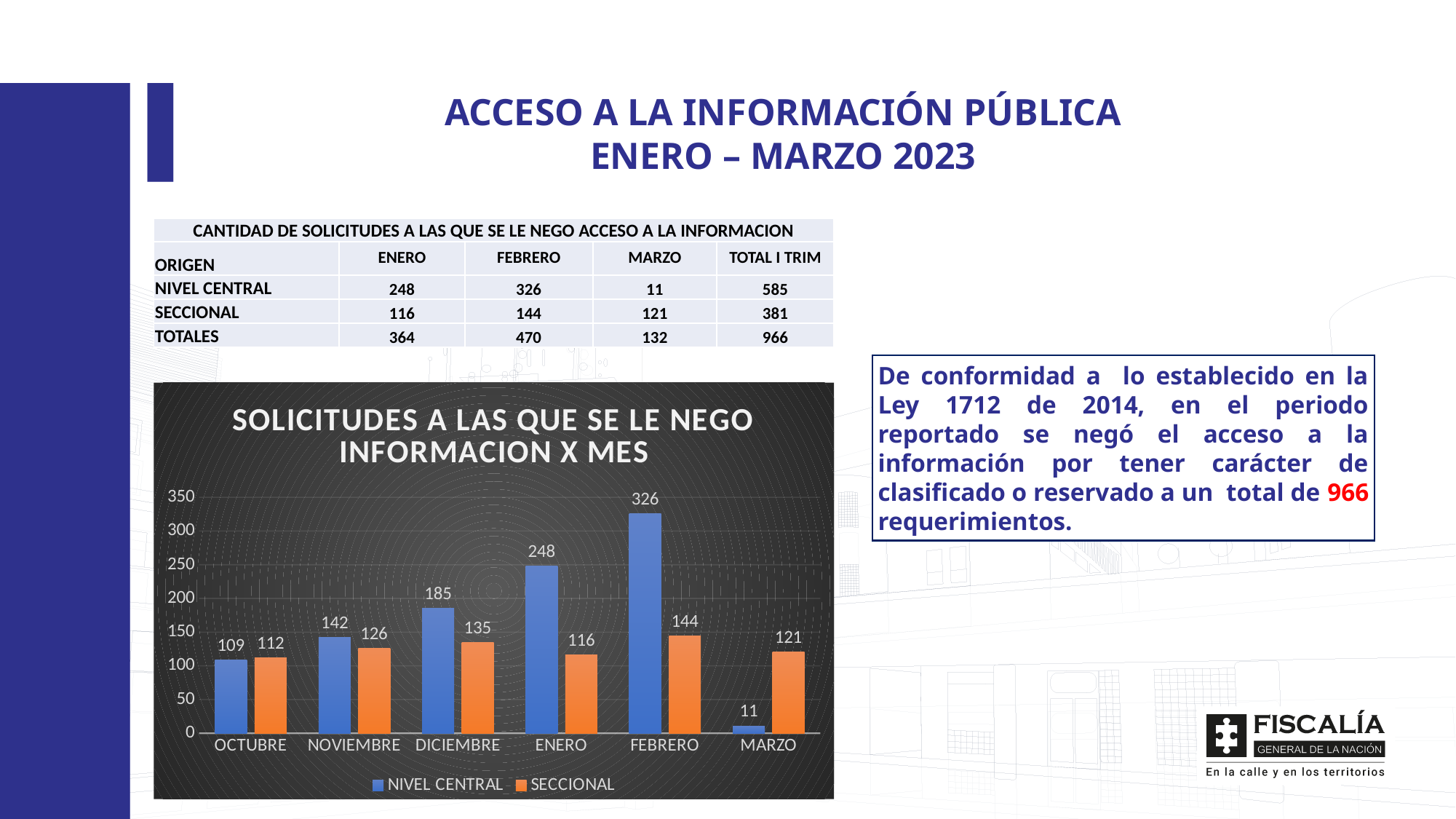
What is the difference between NIVEL CENTRAL and SECCIONAL in ENERO? 132 What is the value for NIVEL CENTRAL in MARZO? 11 How many months are shown on the x axis of the chart? 6 How many series does the chart legend list? 2 In which month is the NIVEL CENTRAL value highest? FEBRERO What is the value for SECCIONAL in DICIEMBRE? 135 In which month is the NIVEL CENTRAL value lowest? MARZO Which is larger in NOVIEMBRE, NIVEL CENTRAL or SECCIONAL? NIVEL CENTRAL What is the value for NIVEL CENTRAL in FEBRERO? 326 What kind of chart is shown on the slide? Bar chart What is the title of the chart? SOLICITUDES A LAS QUE SE LE NEGO INFORMACION X MES In which month is the SECCIONAL value highest? FEBRERO